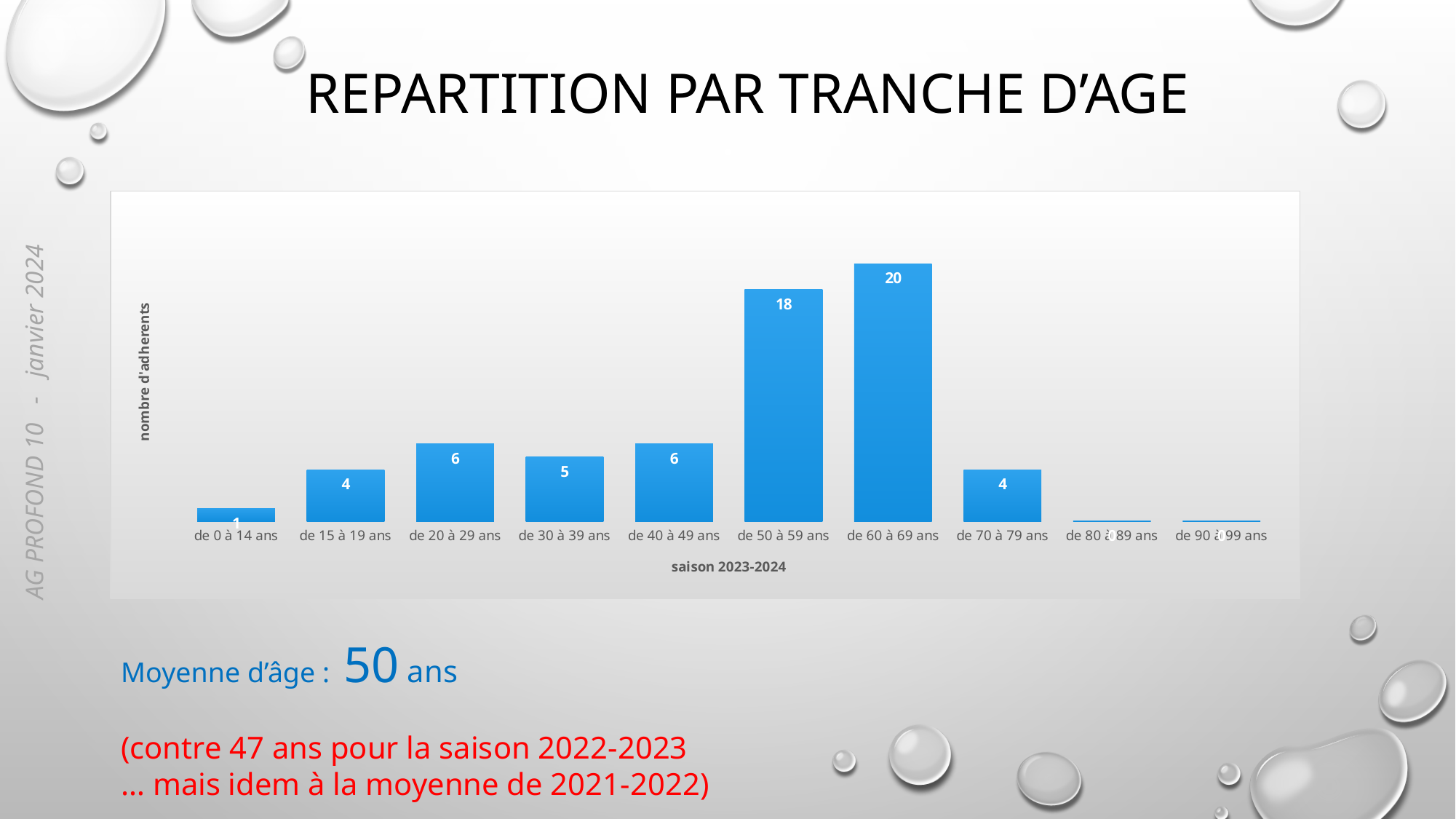
What is the difference between the values for 'de 50 à 59 ans' and 'de 70 à 79 ans'? 14 What is the value for 'de 0 à 14 ans'? 1 How many adherents are in the 'de 60 à 69 ans' age group? 20 What is the difference between the values for 'de 60 à 69 ans' and 'de 50 à 59 ans'? 2 How many age groups are shown on the x axis? 10 What is the title of the horizontal axis? saison 2023-2024 Which is larger, the value for 'de 20 à 29 ans' or 'de 30 à 39 ans'? de 20 à 29 ans Which age group has the highest number of adherents? de 60 à 69 ans What type of chart is shown on the slide? bar chart What is the value for 'de 30 à 39 ans'? 5 What is the value for 'de 50 à 59 ans'? 18 What is the title of the vertical axis? nombre d'adherents